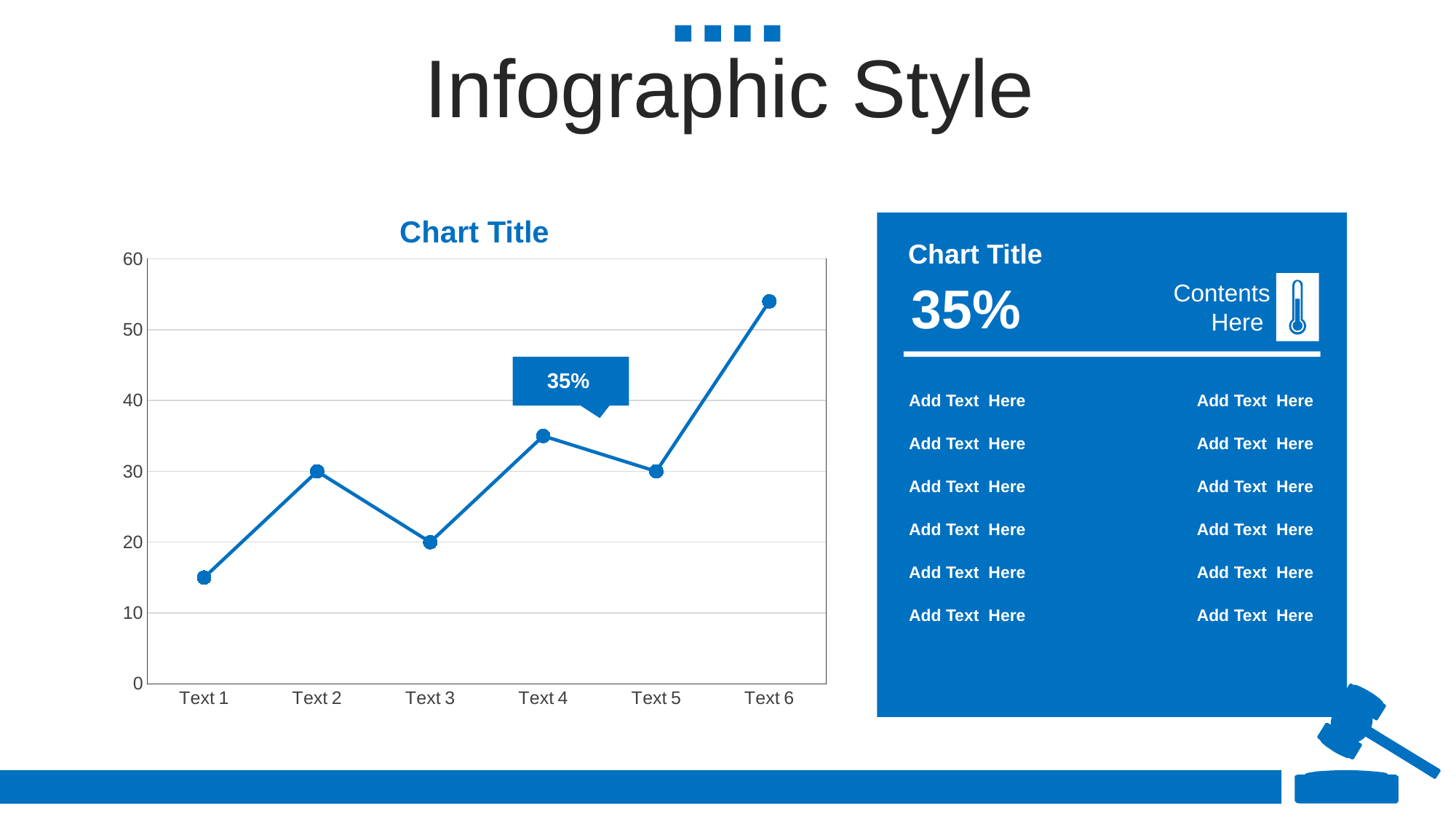
Which category has the lowest value in the line chart? Text 1 Which is larger in the line chart, the value for Text 2 or the value for Text 3? Text 2 What is the value for Text 2 in the line chart? 30 Is the value for Text 6 greater or less than 50? greater Is the value for Text 1 greater or less than 20? less What is the title of the line chart? Chart Title What kind of chart is shown on the left of the slide? line chart What is the value for Text 3 in the line chart? 20 What value is labelled on the line chart at Text 4? 35% How many categories are plotted along the x axis of the line chart? 6 Which category has the highest value in the line chart? Text 6 What is the difference between the values for Text 2 and Text 3 in the line chart? 10